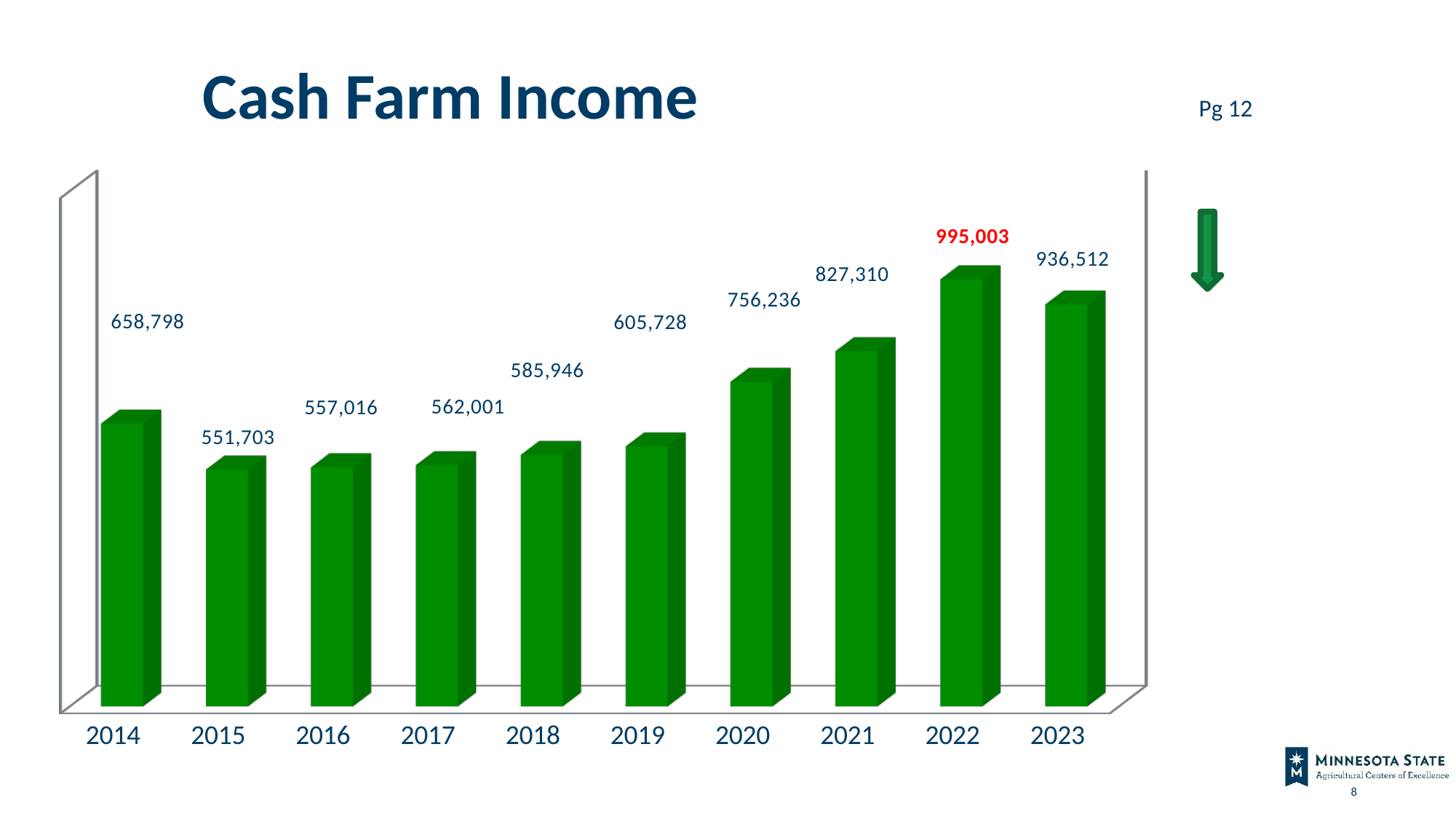
Do the values generally rise or fall from 2015 to 2022? Rise What is the cash farm income value for 2023? 936,512 What kind of chart is shown on the slide? Bar chart How many years are shown on the x axis? 10 Which is larger, the value for 2016 or the value for 2017? 2017 What is the difference between the 2022 and 2023 values? 58,491 Which year has the highest cash farm income? 2022 Which year has the lowest cash farm income? 2015 What is the cash farm income value for 2020? 756,236 What is the cash farm income value for 2014? 658,798 What is the title of the chart? Cash Farm Income What is the difference between the 2021 and 2020 values? 71,074